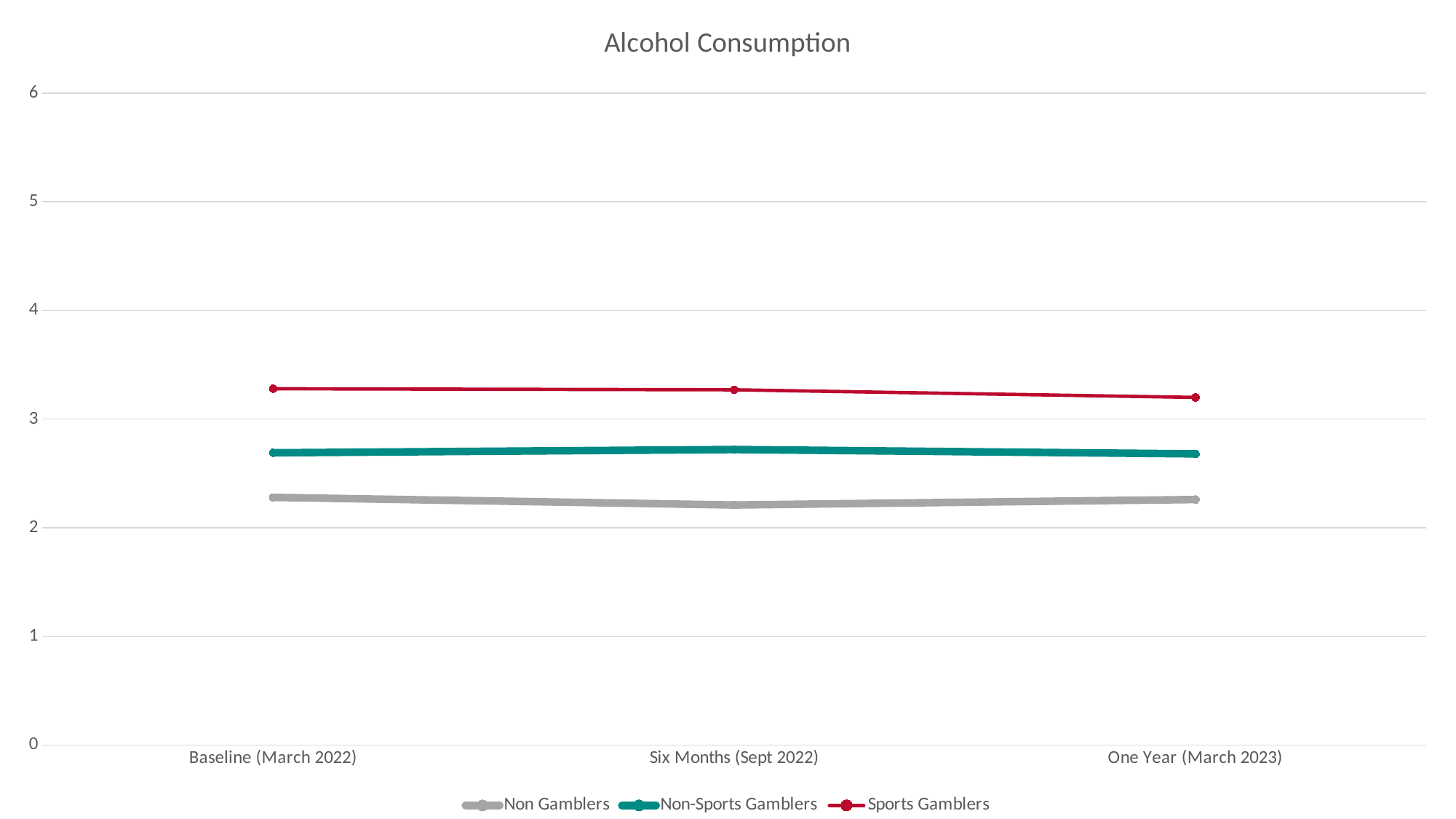
Is the value for Sports Gamblers at Baseline (March 2022) greater or less than 3? greater What kind of chart is shown on the slide? line chart Is the value for Non Gamblers at Six Months (Sept 2022) greater or less than 3? less Which series has the lowest values across all time points? Non Gamblers Does the Sports Gamblers line rise or fall from Baseline (March 2022) to One Year (March 2023)? fall How many time points are shown on the x axis? 3 What is the title of the chart? Alcohol Consumption How many series does the legend list? 3 Is the value for Non-Sports Gamblers at One Year (March 2023) greater or less than 2? greater At One Year (March 2023), which is larger: the value for Sports Gamblers or the value for Non-Sports Gamblers? Sports Gamblers Which series is drawn in red? Sports Gamblers Which series has the highest values across all time points? Sports Gamblers